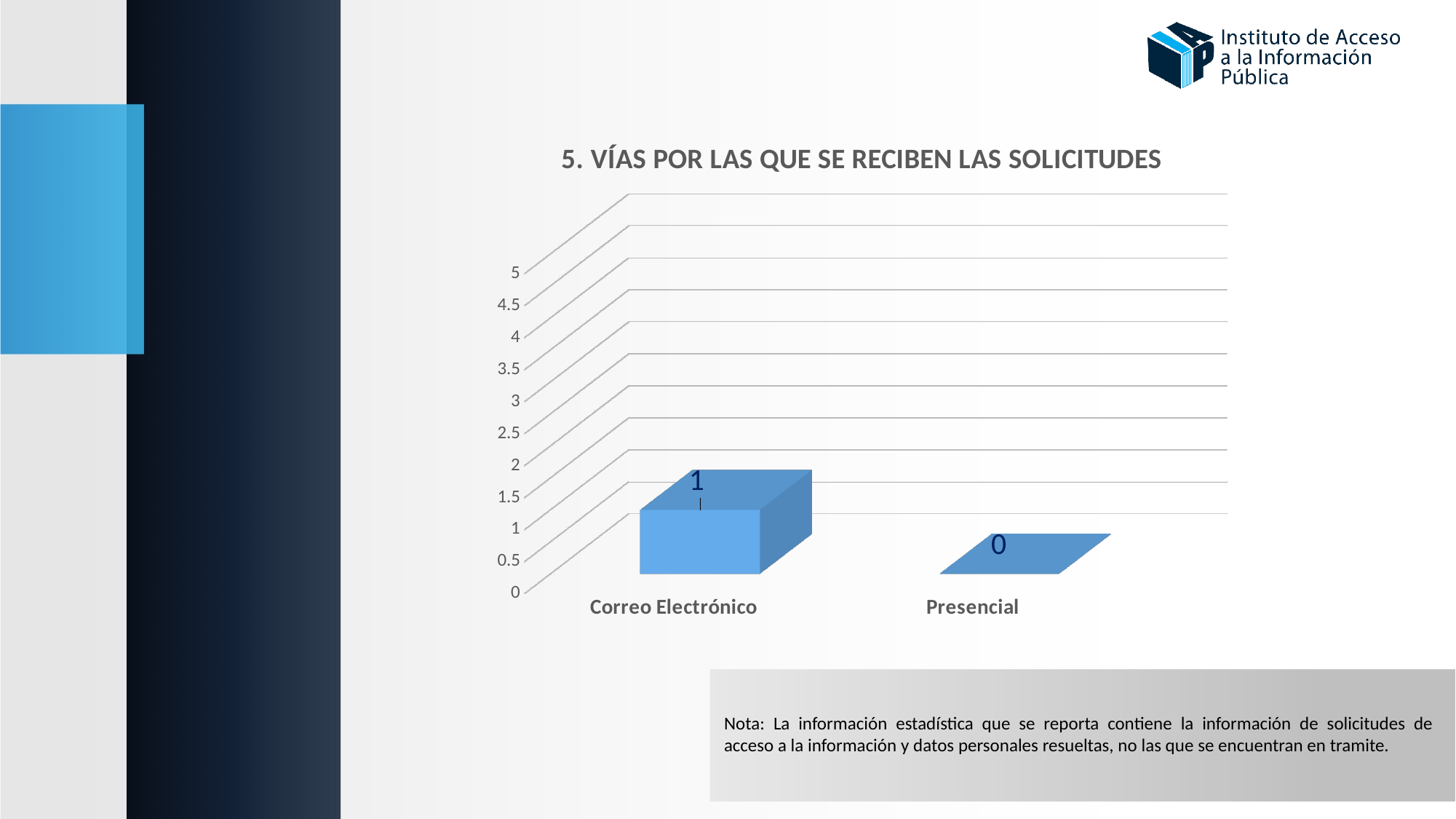
Which category has the lowest value? Presencial Which is larger, the value for Correo Electrónico or the value for Presencial? Correo Electrónico Do the values rise or fall from Correo Electrónico to Presencial? fall What is the value for Correo Electrónico? 1 Is the value for Correo Electrónico greater or less than 2? less What kind of chart is shown on the slide? bar chart What is the difference between the values for Correo Electrónico and Presencial? 1 What is the highest value shown on the vertical axis? 5 How many categories are shown on the x axis? 2 What is the value for Presencial? 0 Which category has the highest value? Correo Electrónico What is the title of the chart? 5. VÍAS POR LAS QUE SE RECIBEN LAS SOLICITUDES